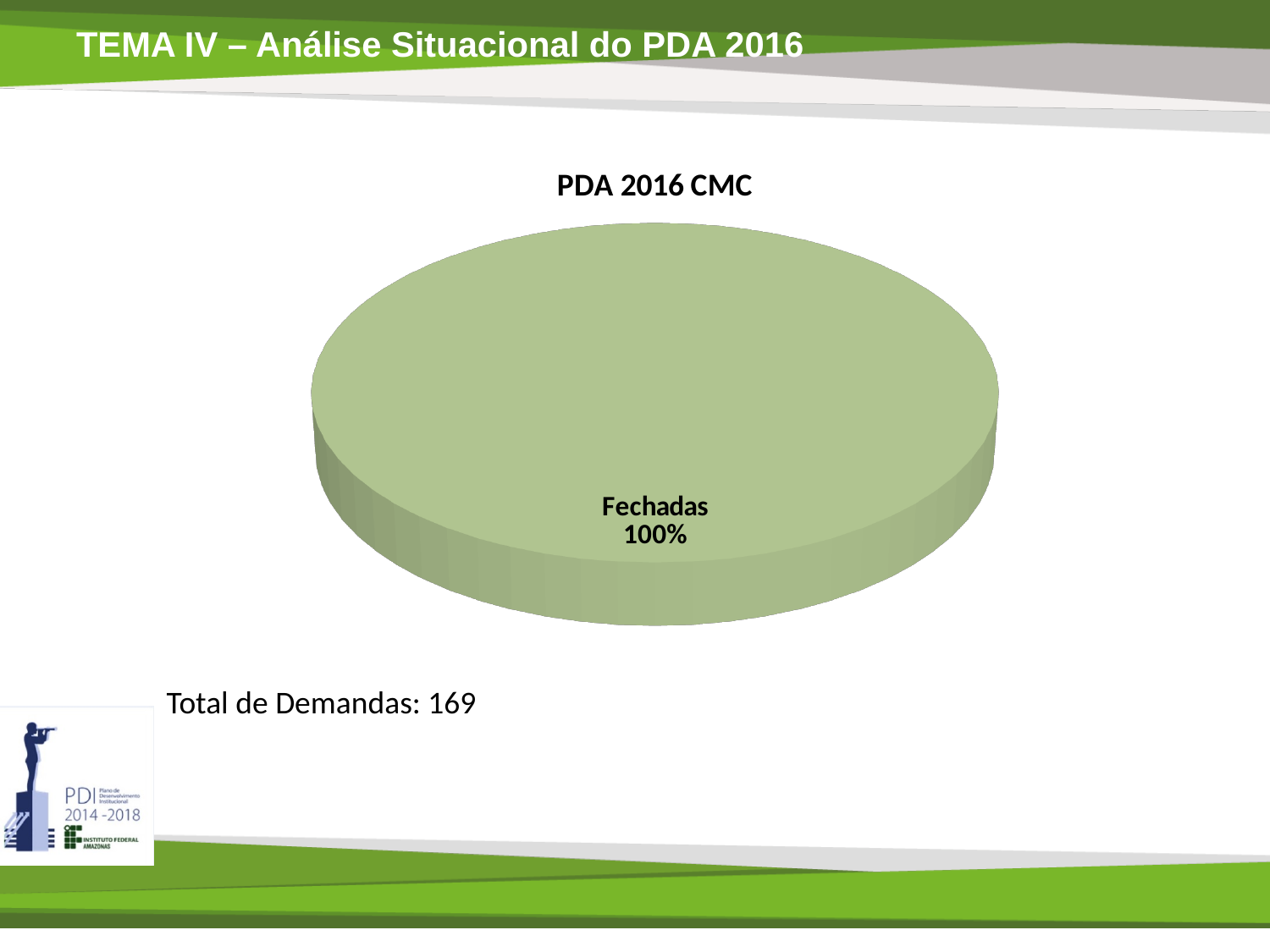
What is the label of the only slice in the pie chart? Fechadas Which category has the largest share of the pie? Fechadas How many slices does the pie chart have? 1 What is the total number of demands stated below the chart? 169 What share of the pie does the Fechadas slice represent? 100% What kind of chart is shown on the slide? pie chart What is the title of the chart? PDA 2016 CMC Is the share for Fechadas greater or less than 50%? greater